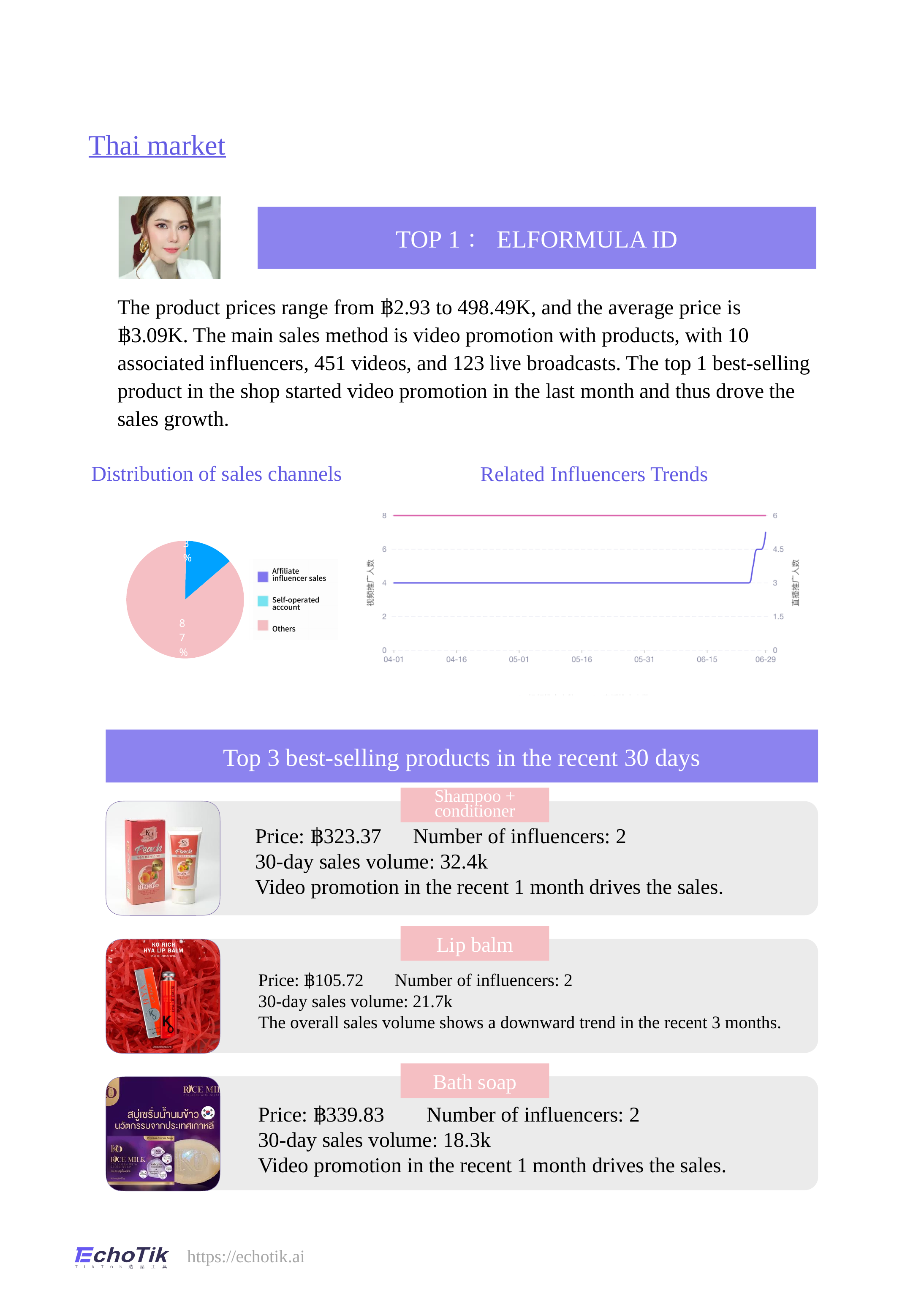
In the Distribution of sales channels chart, which category has the largest slice? Others In the Distribution of sales channels chart, what colour represents Others in the legend? Pink In the Related Influencers Trends chart, what is the highest tick value on the left y axis? 8 In the Related Influencers Trends chart, what is the first date label on the x axis? 04-01 How many date labels are shown on the x axis of the Related Influencers Trends chart? 7 In the Related Influencers Trends chart, does the purple line rise or fall near the end of the period? Rises In the Distribution of sales channels chart, what share of sales does Others account for? 87% In the Distribution of sales channels chart, is the share for Others greater or less than 50%? greater What kind of chart is the Distribution of sales channels chart? Pie chart How many entries does the legend of the Distribution of sales channels chart list? 3 In the Related Influencers Trends chart, does the pink line rise, fall, or stay flat across the period? Stays flat What kind of chart is the Related Influencers Trends chart? Line chart